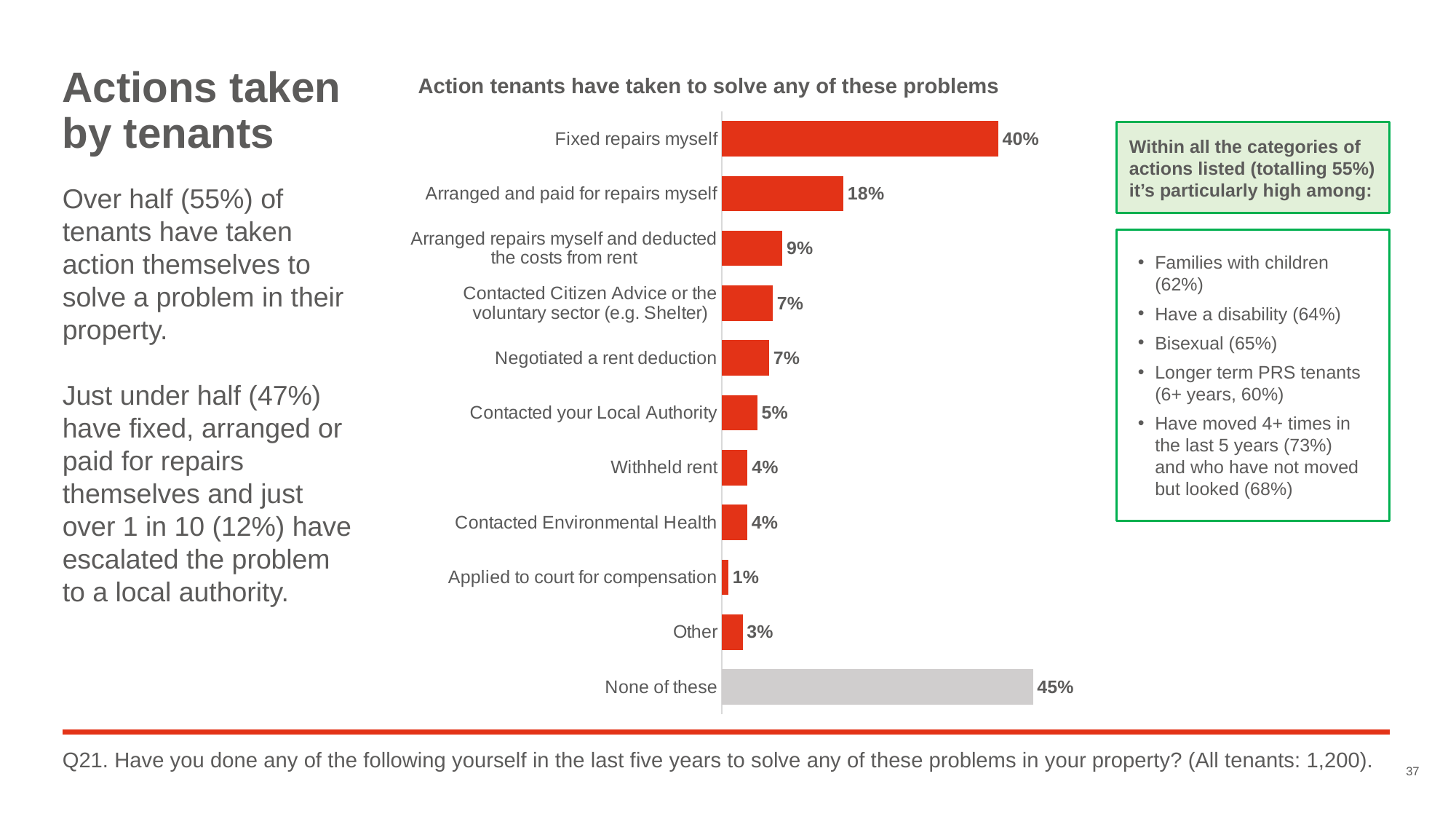
What percentage of tenants said they fixed repairs themselves? 40% What type of chart is shown on the slide? Bar chart Which bar is coloured grey rather than red? None of these What is the difference between 'Fixed repairs myself' and 'Arranged and paid for repairs myself'? 22 percentage points What is the value for 'None of these'? 45% Which is larger: 'Withheld rent' or 'Contacted your Local Authority'? Contacted your Local Authority What is the title of the chart? Action tenants have taken to solve any of these problems Which action category has the highest value? None of these How many categories are shown in the chart? 11 What is the value for 'Arranged and paid for repairs myself'? 18% Which category has the lowest value? Applied to court for compensation What percentage of tenants contacted their Local Authority? 5%